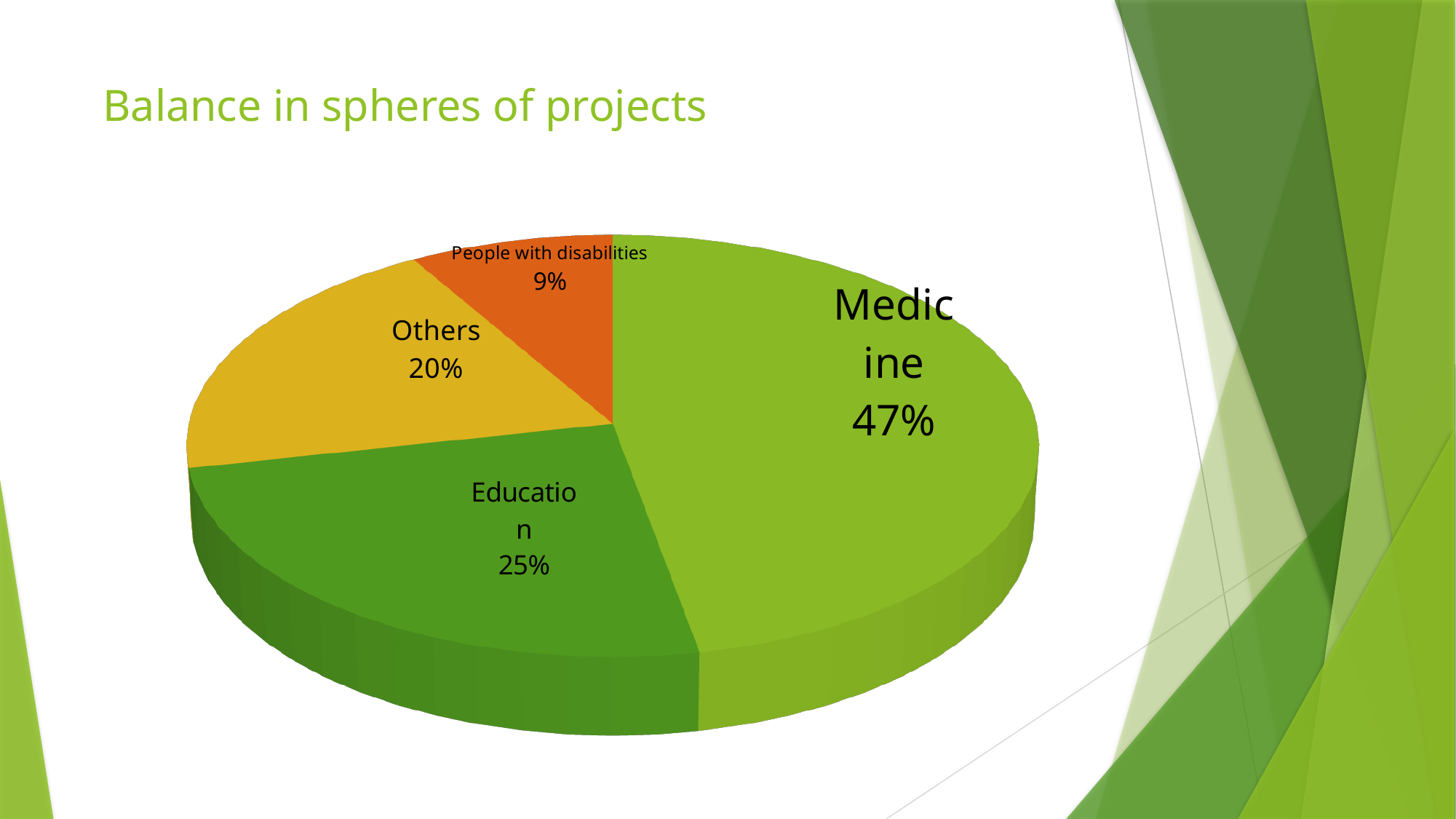
What share of the pie does Medicine account for? 47% Which has a larger share, Education or Others? Education What percentage is shown for Others? 20% What is the title of the slide containing the chart? Balance in spheres of projects What percentage is shown for Education? 25% What is the difference in percentage points between Medicine and Education? 22 What is the difference in percentage points between Others and People with disabilities? 11 Which sphere has the smallest share of the pie? People with disabilities How many slices does the pie chart have? 4 What kind of chart is shown on the slide? Pie chart Which sphere has the largest share of the pie? Medicine What percentage is shown for People with disabilities? 9%